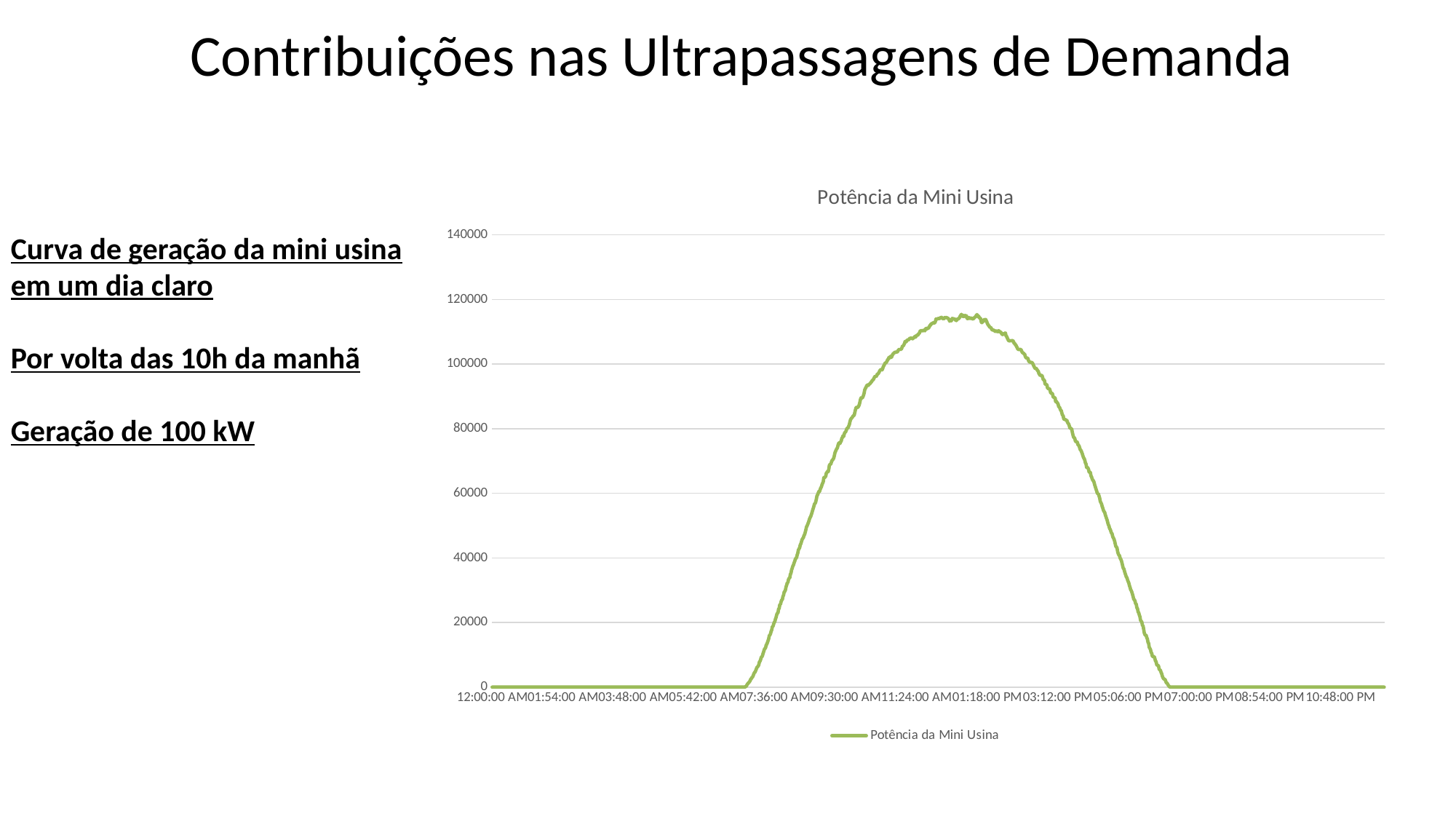
Is the value of Potência da Mini Usina at 09:30:00 AM greater or less than 40000? greater What is the value of Potência da Mini Usina at 10:48:00 PM? 0 Does the value of Potência da Mini Usina rise or fall between 01:18:00 PM and 07:00:00 PM? fall Is the value of Potência da Mini Usina at 05:06:00 PM greater or less than 80000? less What colour is the line for Potência da Mini Usina? green Does the value of Potência da Mini Usina rise or fall between 07:36:00 AM and 01:18:00 PM? rise What is the value of Potência da Mini Usina at 12:00:00 AM? 0 How many series does the legend of the chart list? 1 What kind of chart is shown on the slide? line chart Is the value of Potência da Mini Usina at 11:24:00 AM greater or less than 100000? greater What is the title of the chart? Potência da Mini Usina